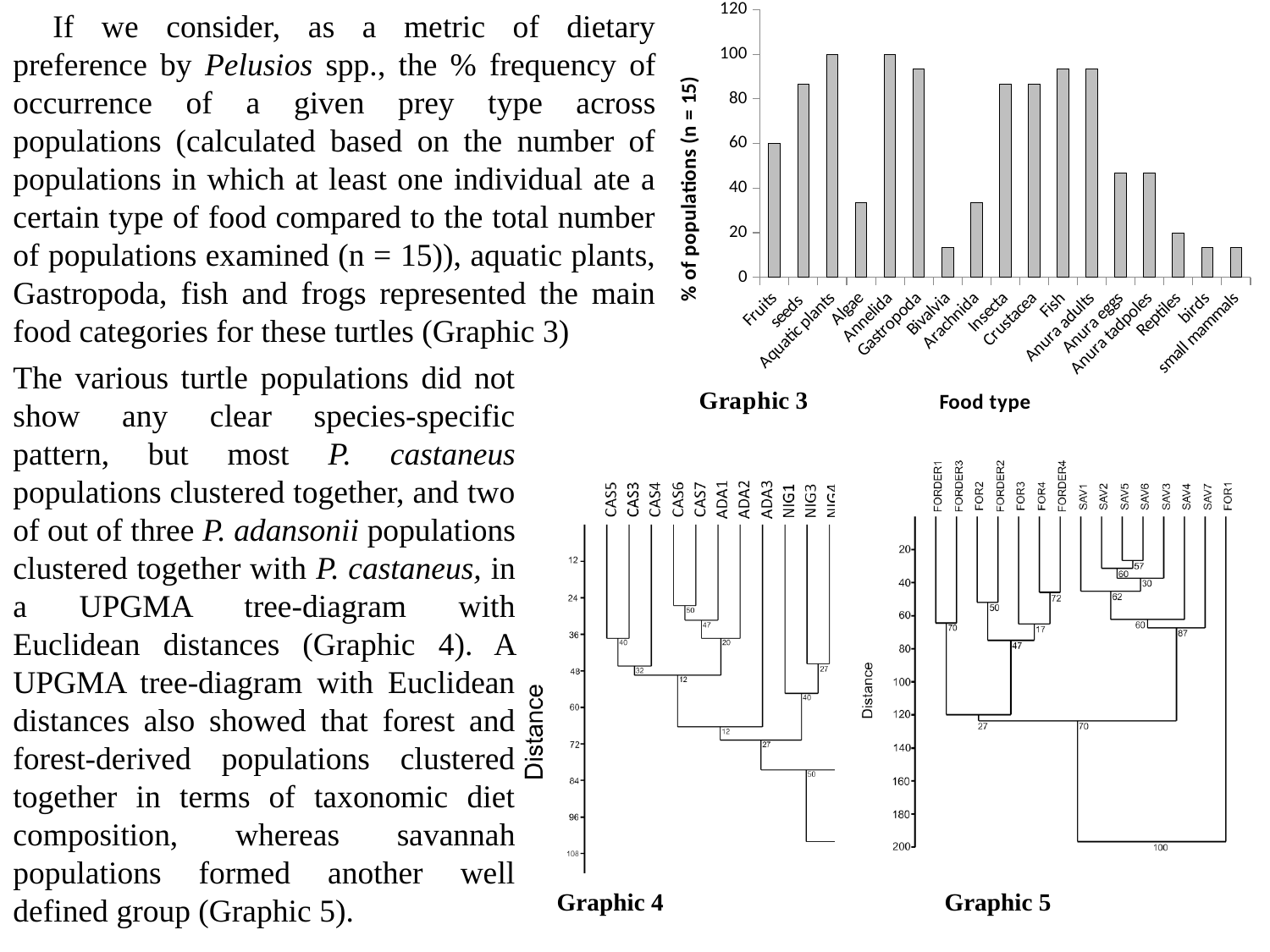
In Graphic 3, what is the % of populations for Reptiles? 20 In Graphic 3, is the value for Bivalvia greater or less than 20? less In Graphic 4, how many populations are listed across the top of the tree-diagram? 11 In Graphic 3, is the value for Gastropoda greater or less than 80? greater In Graphic 3, what is the label of the y axis? % of populations (n = 15) In Graphic 3, is the value for Algae greater or less than 40? less In Graphic 3, what kind of chart is shown? bar chart In Graphic 3, what is the % of populations for Aquatic plants? 100 In Graphic 3, how many food type categories are plotted? 17 In Graphic 3, what is the % of populations for Annelida? 100 In Graphic 3, which has a higher % of populations, Fish or Reptiles? Fish In Graphic 3, what is the % of populations for Fruits? 60